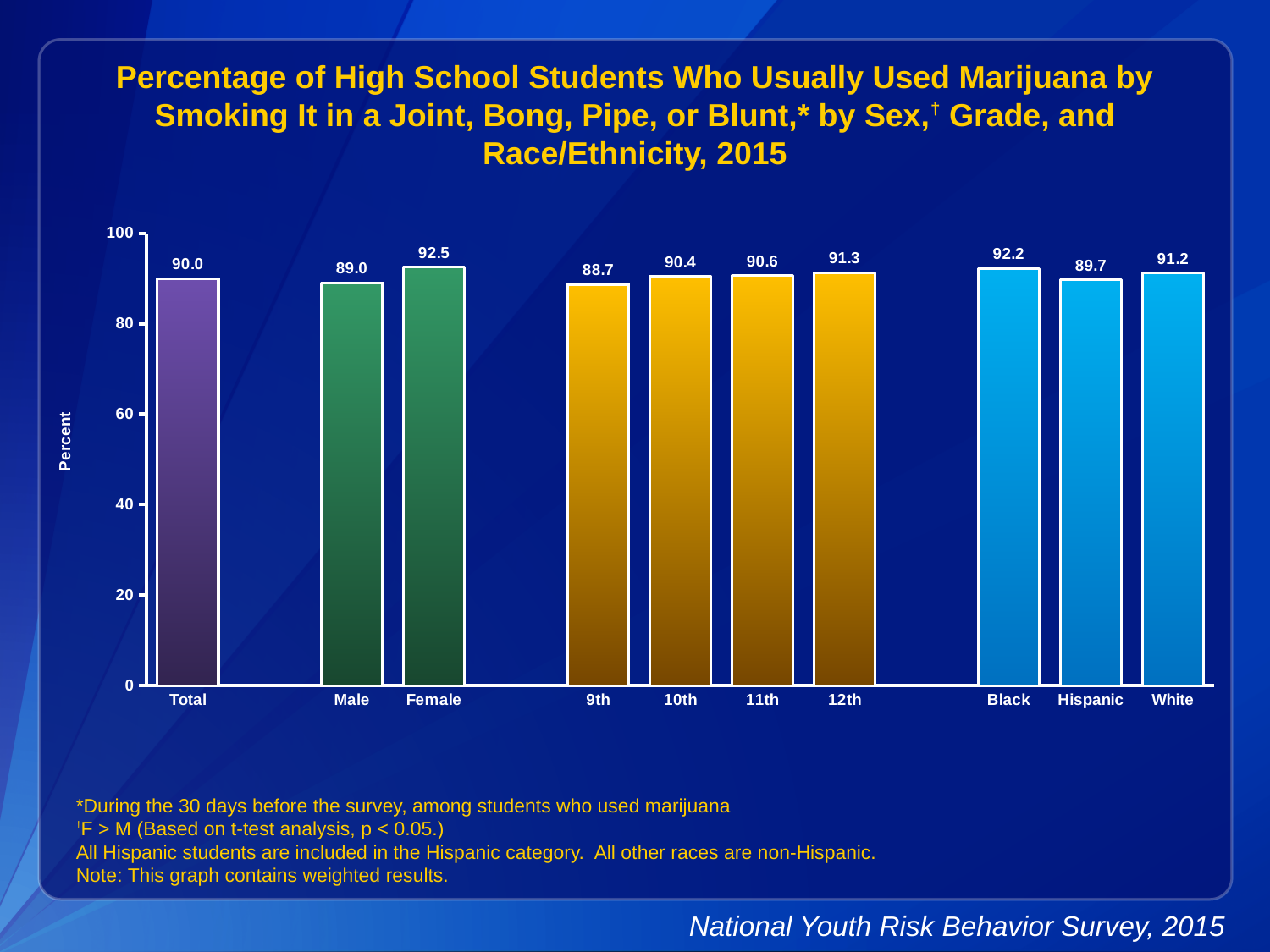
What is the value for 9th grade? 88.7 Which category has the highest value? Female What is the difference between the Female and Male values? 3.5 How many categories are shown on the x axis? 10 What is the difference between the Black and Hispanic values? 2.5 What is the value for Hispanic students? 89.7 Which category has the lowest value? 9th What is the value for Female? 92.5 What is the value for Total? 90.0 What kind of chart is shown on the slide? Bar chart Do the values rise or fall from 9th grade to 12th grade? Rise Which is larger, the value for 12th grade or the value for 9th grade? 12th